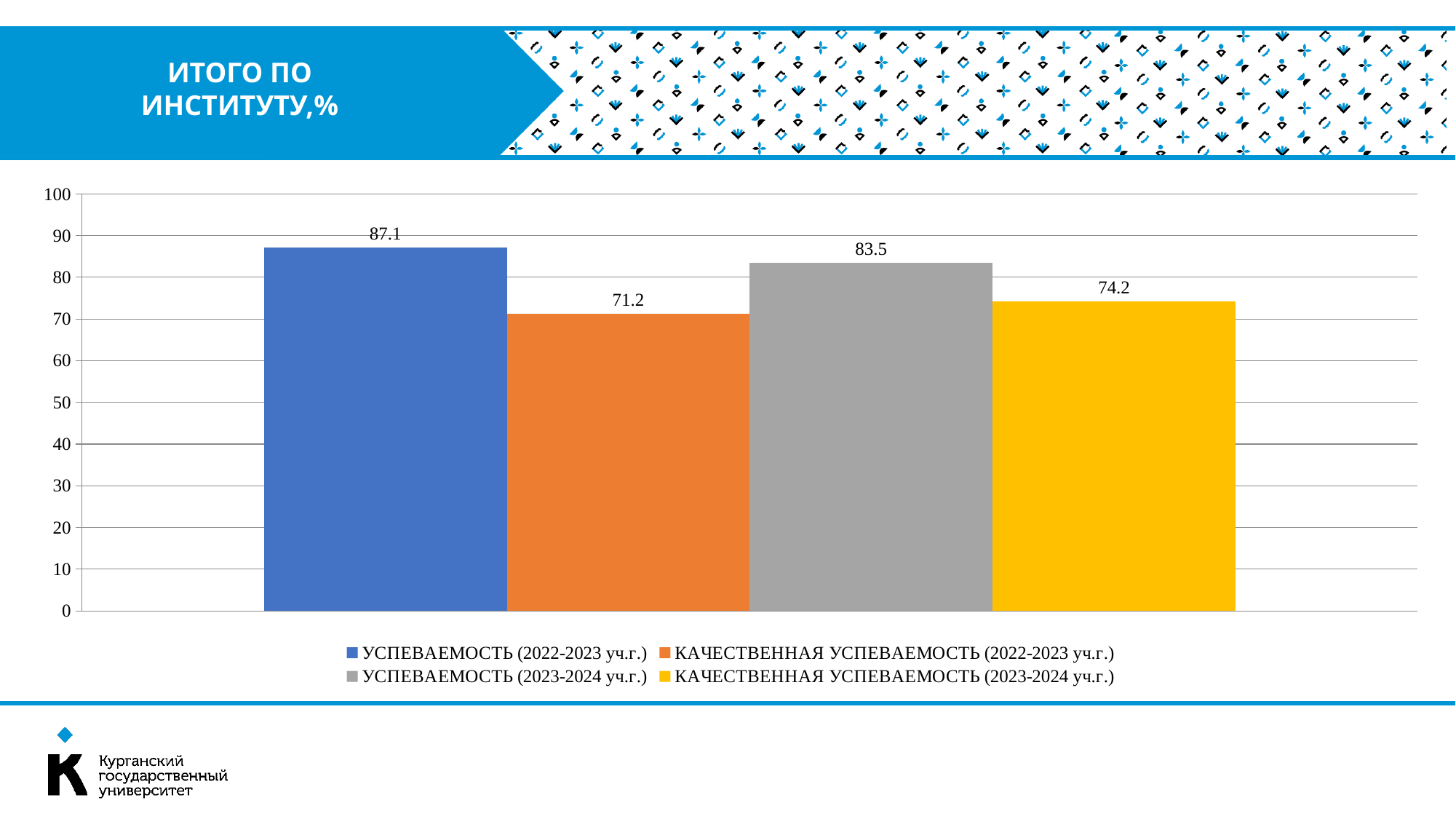
How many series does the legend list? 4 Which series has the lowest value? КАЧЕСТВЕННАЯ УСПЕВАЕМОСТЬ (2022-2023 уч.г.) What is the value for УСПЕВАЕМОСТЬ (2022-2023 уч.г.)? 87.1 What is the value for КАЧЕСТВЕННАЯ УСПЕВАЕМОСТЬ (2022-2023 уч.г.)? 71.2 What kind of chart is shown on the slide? Bar chart What colour is the bar for УСПЕВАЕМОСТЬ (2023-2024 уч.г.)? Grey What is the value for КАЧЕСТВЕННАЯ УСПЕВАЕМОСТЬ (2023-2024 уч.г.)? 74.2 What is the difference between УСПЕВАЕМОСТЬ (2022-2023 уч.г.) and УСПЕВАЕМОСТЬ (2023-2024 уч.г.)? 3.6 Which series has the highest value? УСПЕВАЕМОСТЬ (2022-2023 уч.г.) What is the value for УСПЕВАЕМОСТЬ (2023-2024 уч.г.)? 83.5 Which is larger: КАЧЕСТВЕННАЯ УСПЕВАЕМОСТЬ (2022-2023 уч.г.) or КАЧЕСТВЕННАЯ УСПЕВАЕМОСТЬ (2023-2024 уч.г.)? КАЧЕСТВЕННАЯ УСПЕВАЕМОСТЬ (2023-2024 уч.г.) What is the difference between КАЧЕСТВЕННАЯ УСПЕВАЕМОСТЬ (2023-2024 уч.г.) and КАЧЕСТВЕННАЯ УСПЕВАЕМОСТЬ (2022-2023 уч.г.)? 3